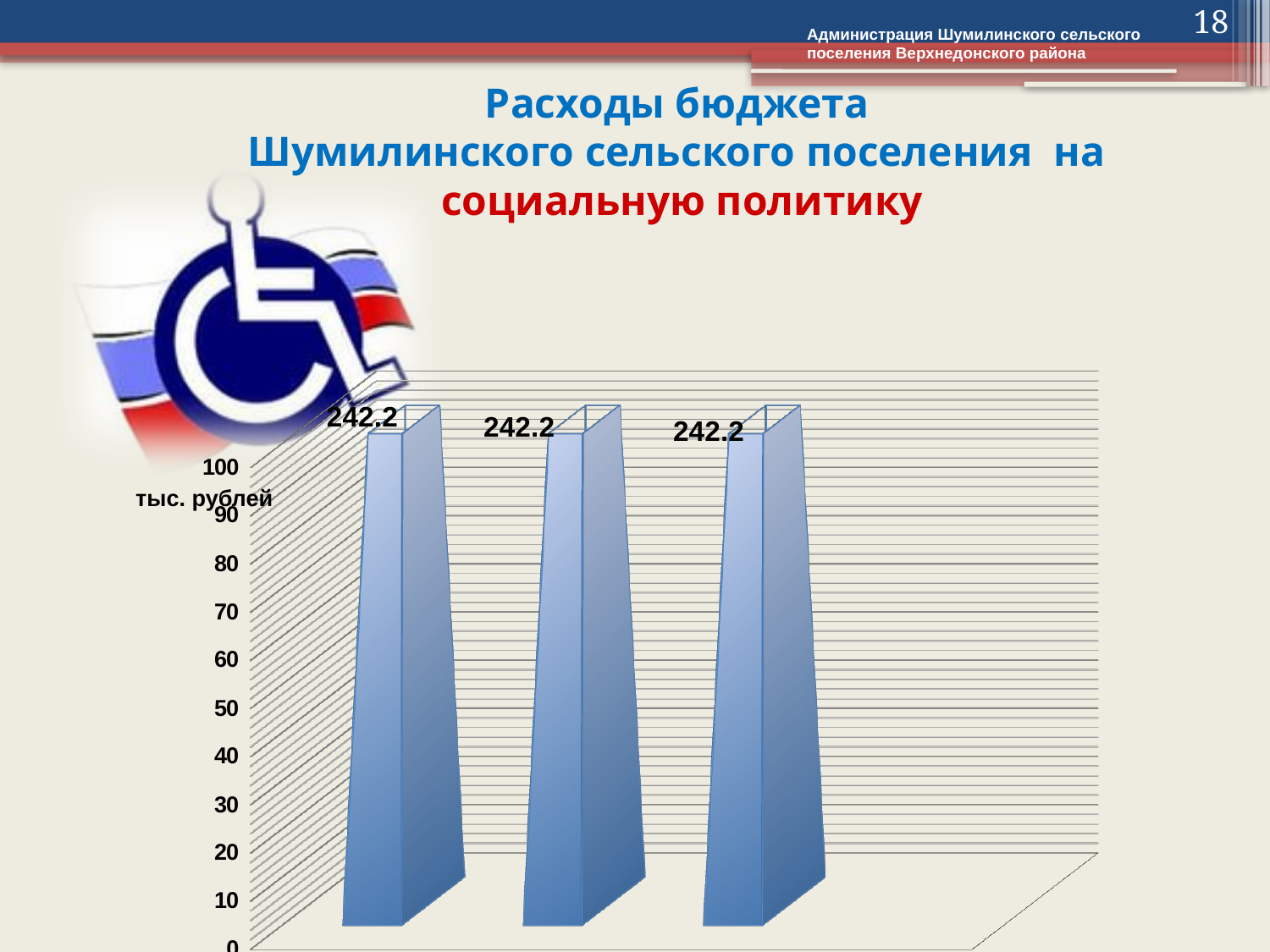
What unit is shown on the vertical axis of the chart? тыс. рублей What is the data label on the first (leftmost) bar? 242.2 What is the data label on the middle bar? 242.2 What kind of chart is shown on the slide? bar chart Is the value of the leftmost bar larger than, smaller than, or equal to the value of the rightmost bar? equal What is the data label on the third (rightmost) bar? 242.2 Do the values rise, fall, or stay the same from left to right across the bars? stay the same What is the highest tick value shown on the vertical axis? 100 What is the difference between the value of the first bar and the value of the third bar? 0 How many bars are plotted in the chart? 3